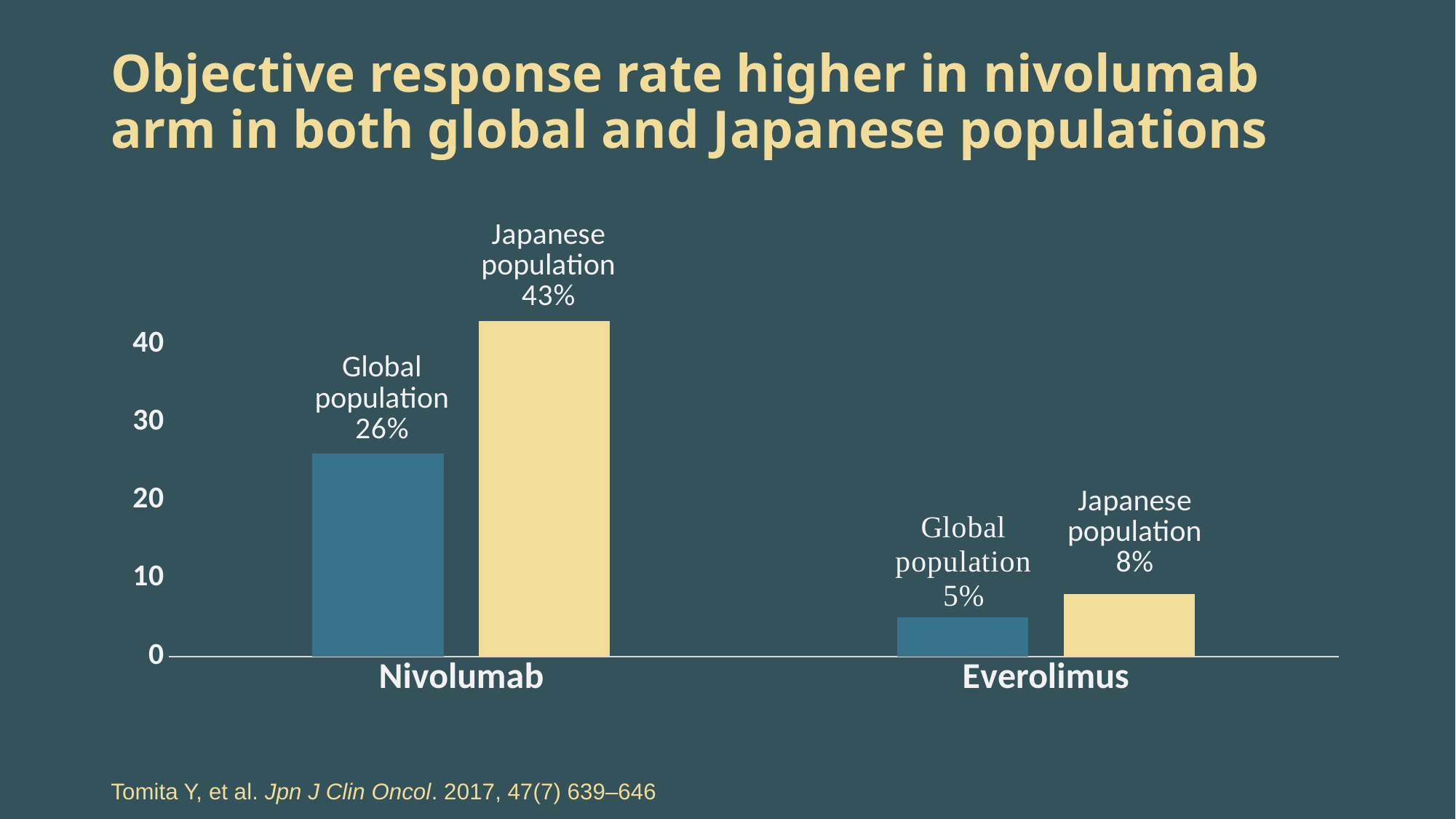
What type of chart is shown on the slide? Bar chart What is the objective response rate for the Global population in the Nivolumab arm? 26% What colour are the bars for the Japanese population? Yellow Which bar shows the lowest objective response rate? Everolimus, Global population What is the objective response rate for the Japanese population in the Everolimus arm? 8% Which is larger: the Japanese population response rate for Everolimus or the Global population response rate for Nivolumab? Global population response rate for Nivolumab What is the difference between the Japanese population and Global population response rates in the Nivolumab arm? 17% What is the objective response rate for the Japanese population in the Nivolumab arm? 43% How many treatment arms are shown on the x axis? 2 What is the difference between the Global population response rates for Nivolumab and Everolimus? 21% What is the objective response rate for the Global population in the Everolimus arm? 5% Which bar shows the highest objective response rate? Nivolumab, Japanese population